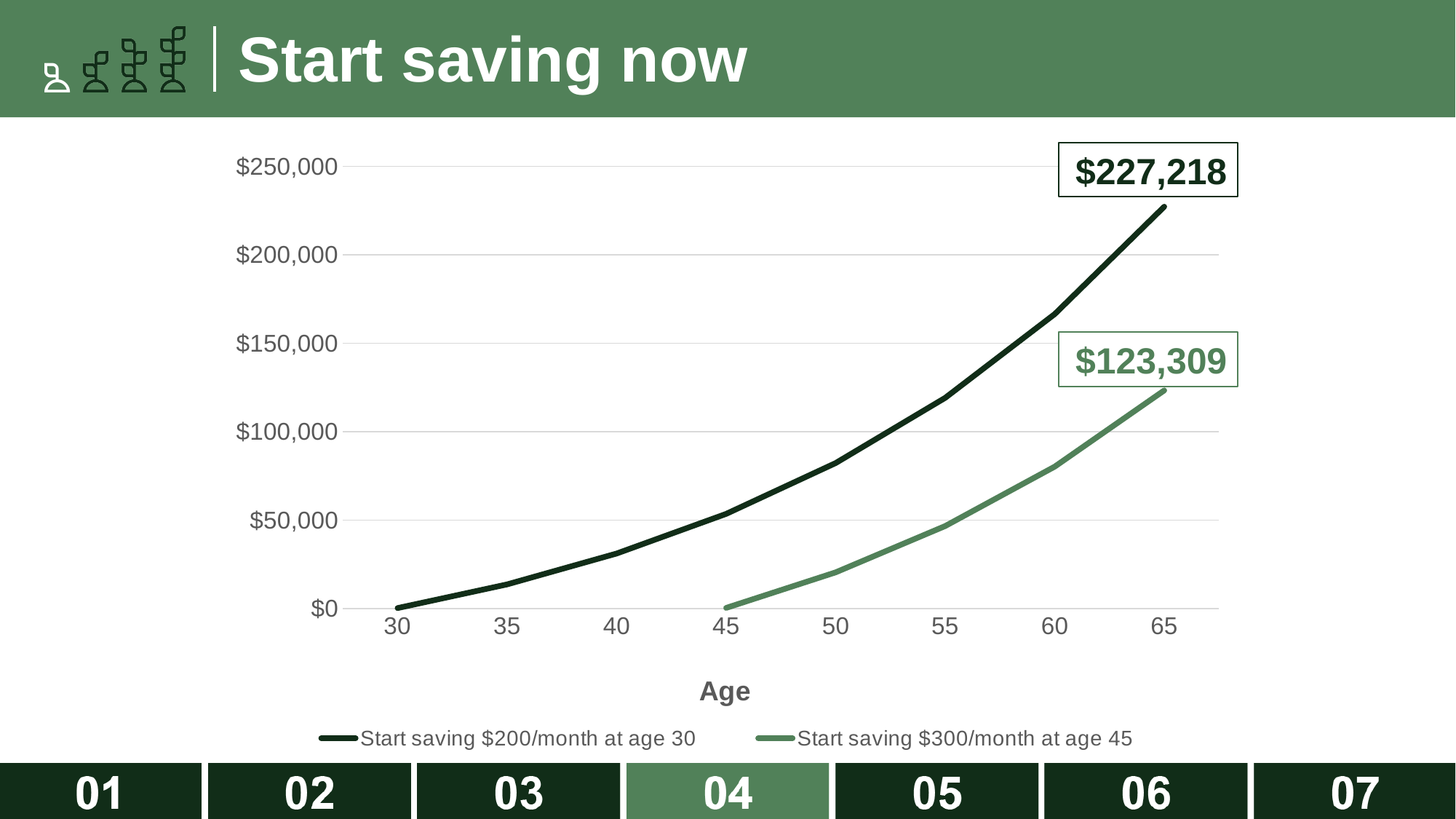
What is the value of the 'Start saving $200/month at age 30' series at age 65? $227,218 Do the values of the 'Start saving $200/month at age 30' series rise or fall as age increases? Rise How many age ticks are shown on the x axis? 8 What is the title of the x axis? Age Is the value for the 'Start saving $200/month at age 30' series at age 50 greater or less than $100,000? less Which series has the larger value at age 65? Start saving $200/month at age 30 Is the value for the 'Start saving $200/month at age 30' series at age 55 greater or less than $100,000? greater Is the value for the 'Start saving $300/month at age 45' series at age 60 greater or less than $100,000? less How many series does the legend list? 2 What is the difference between the two labelled values at age 65? $103,909 What kind of chart is shown on the slide? Line chart What is the value of the 'Start saving $300/month at age 45' series at age 65? $123,309